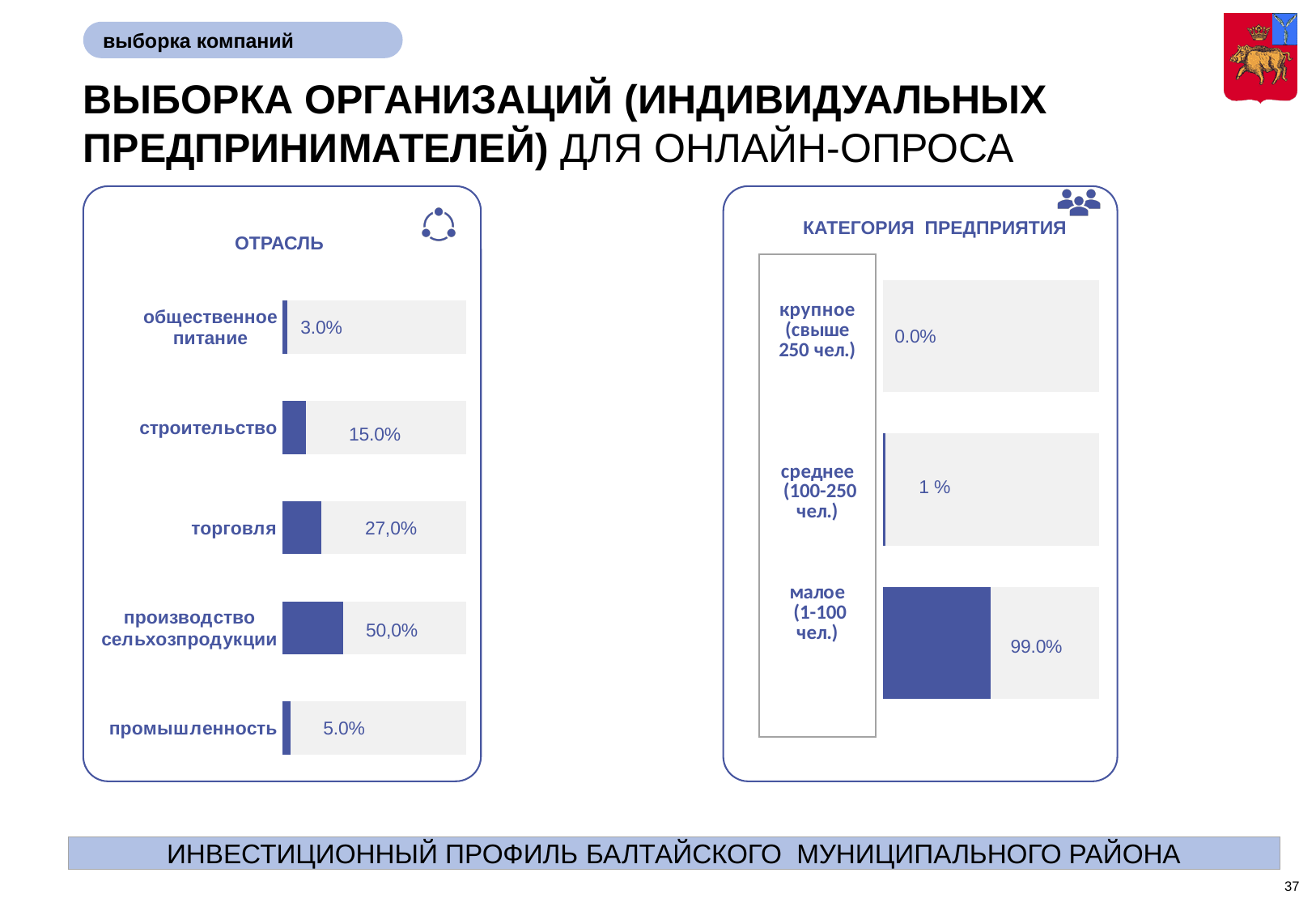
In the ОТРАСЛЬ chart, what is the value for промышленность? 5.0% In the ОТРАСЛЬ chart, what is the value for торговля? 27,0% In the ОТРАСЛЬ chart, what is the value for строительство? 15.0% In the ОТРАСЛЬ chart, which category has the lowest value? общественное питание In the КАТЕГОРИЯ ПРЕДПРИЯТИЯ chart, what is the value for крупное (свыше 250 чел.)? 0.0% In the КАТЕГОРИЯ ПРЕДПРИЯТИЯ chart, what is the value for малое (1-100 чел.)? 99.0% In the ОТРАСЛЬ chart, how many categories are shown? 5 What type of chart is the КАТЕГОРИЯ ПРЕДПРИЯТИЯ chart? bar chart In the ОТРАСЛЬ chart, which category has the highest value? производство сельхозпродукции In the ОТРАСЛЬ chart, which is larger: строительство or торговля? торговля In the ОТРАСЛЬ chart, what is the difference between производство сельхозпродукции and торговля? 23 percentage points In the КАТЕГОРИЯ ПРЕДПРИЯТИЯ chart, how many categories are shown? 3